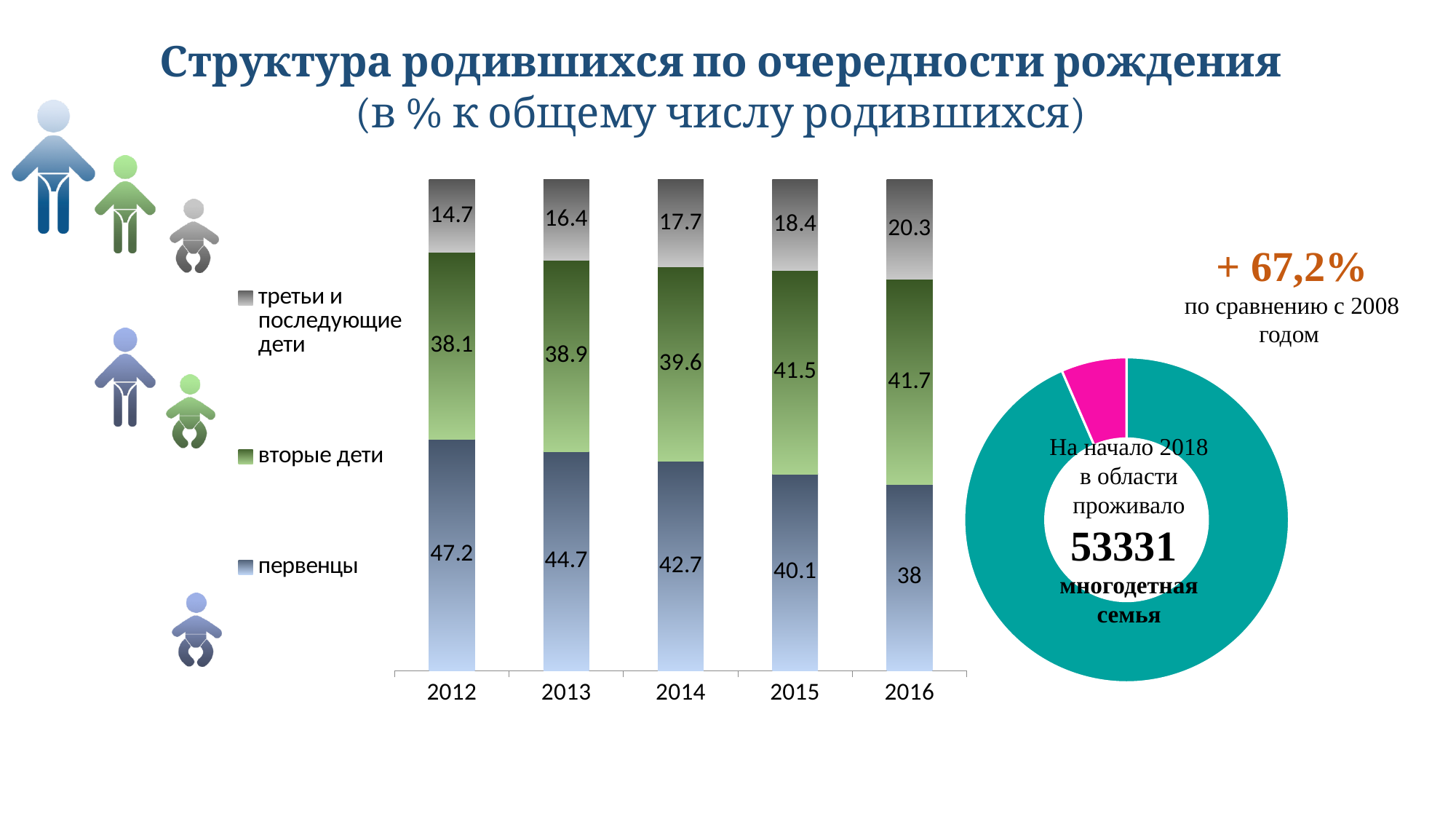
What kind of chart is the one with years 2012 to 2016? stacked bar chart In the stacked bar chart, do the values for третьи и последующие дети rise or fall from 2012 to 2016? rise In the stacked bar chart, which is larger in 2016: первенцы or вторые дети? вторые дети In the stacked bar chart, what is the value for первенцы in 2012? 47.2 In the stacked bar chart, which year has the lowest value for третьи и последующие дети? 2012 In the stacked bar chart, what is the total of the 2014 bar? 100 In the stacked bar chart, which year has the highest value for первенцы? 2012 How many series does the legend of the stacked bar chart list? 3 In the stacked bar chart, what is the difference between the первенцы values for 2012 and 2016? 9.2 In the stacked bar chart, what is the value for вторые дети in 2015? 41.5 In the stacked bar chart, what is the value for третьи и последующие дети in 2016? 20.3 In the stacked bar chart, how many years are shown on the x axis? 5